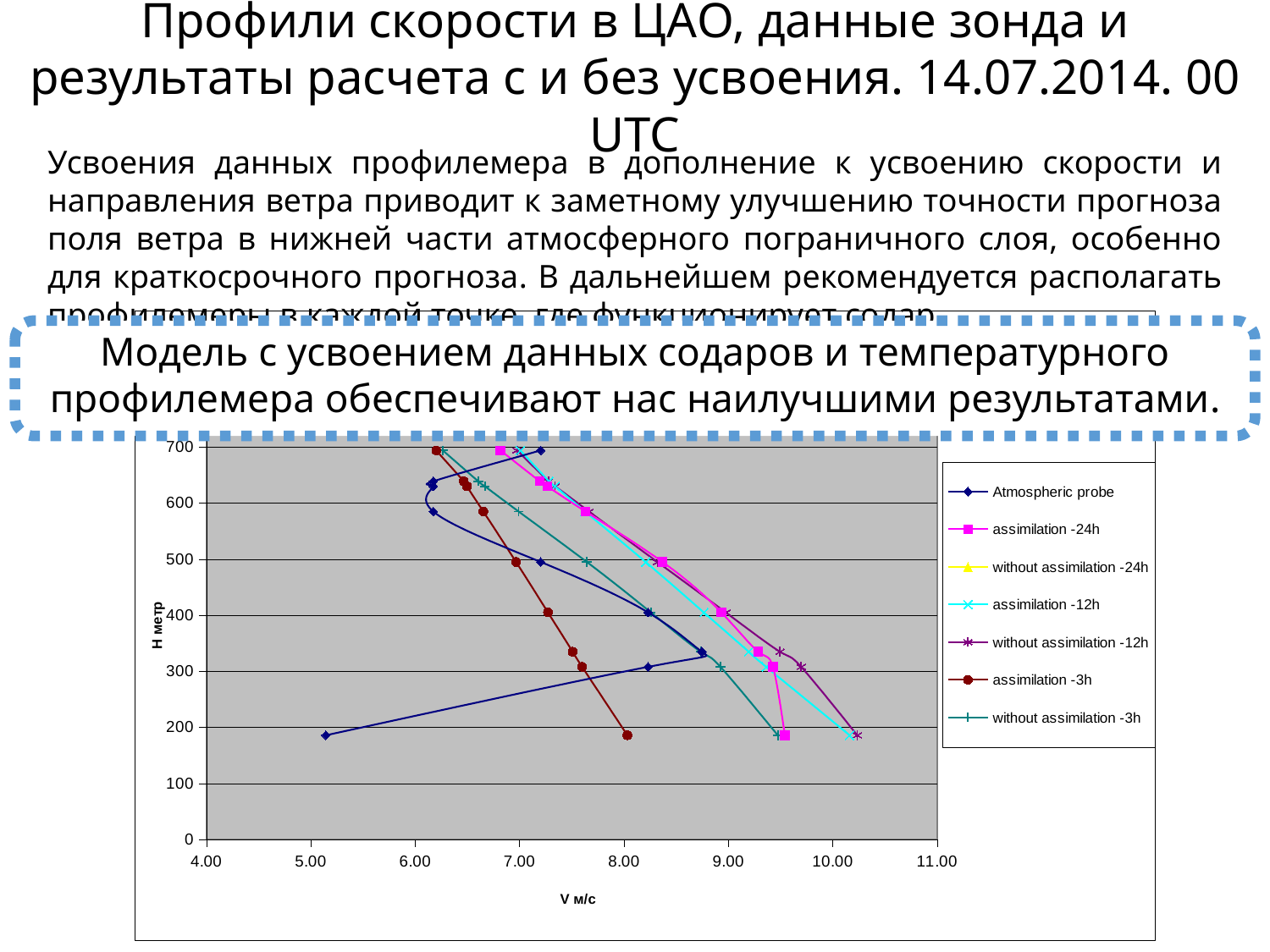
At the lowest plotted height (around 200 m), which has the larger velocity: Atmospheric probe or assimilation -3h? assimilation -3h Is the velocity of the Atmospheric probe series at its lowest height (around 200 m) greater or less than 6.00? less At 700 m, which has the larger velocity: Atmospheric probe or assimilation -3h? Atmospheric probe What is the label of the horizontal axis of the chart? V м/с Which series has the lowest velocity at the lowest plotted height (around 200 m)? Atmospheric probe Is the velocity of the assimilation -3h series at 700 m greater or less than 7.00? less How many series does the chart legend list? 7 Is the velocity of the without assimilation -12h series at its lowest height (around 200 m) greater or less than 9.00? greater For the assimilation -3h series, does velocity increase or decrease as height increases? decrease What kind of chart is shown on the slide? line chart What is the label of the vertical axis of the chart? H метр